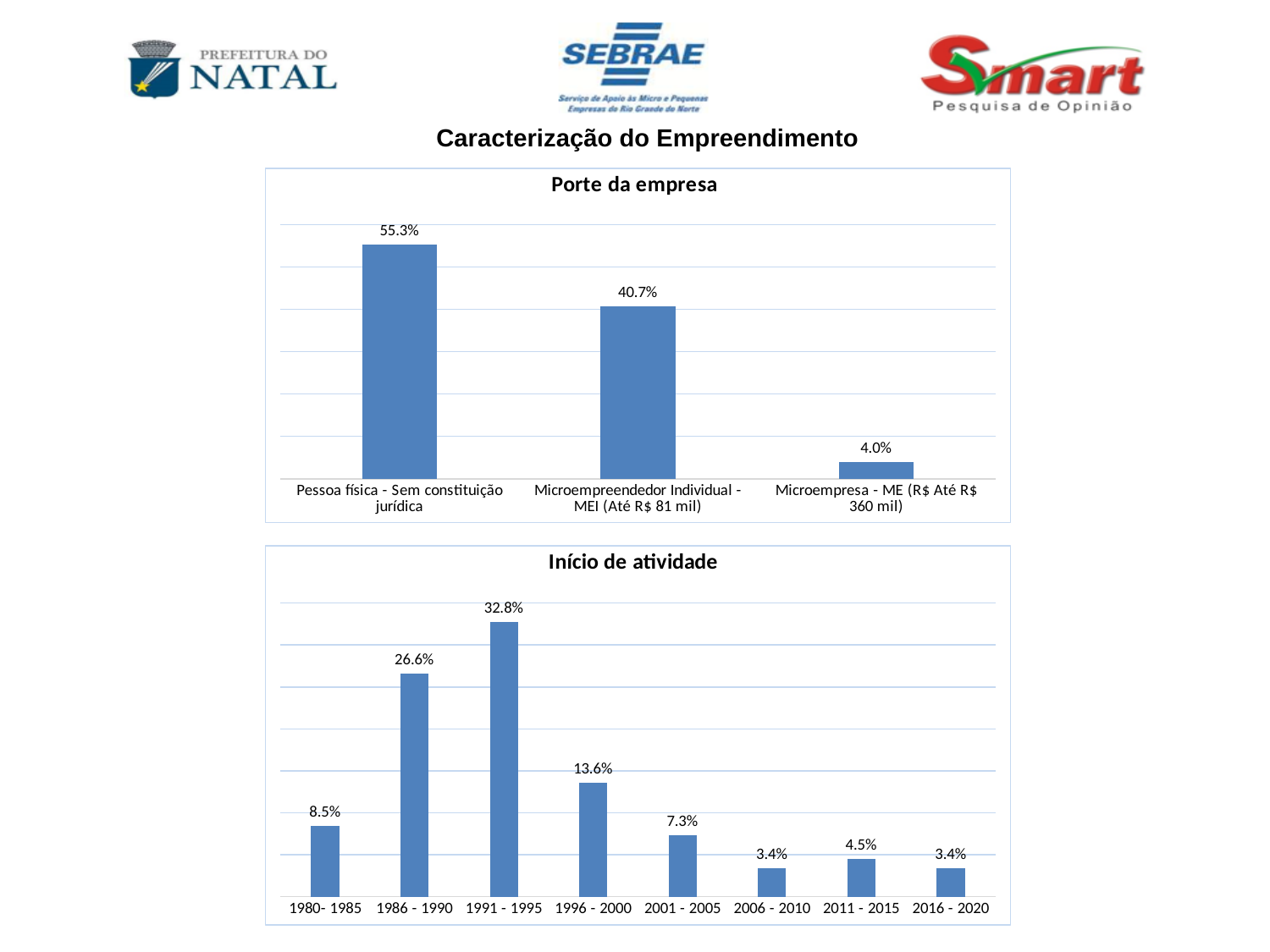
In the 'Porte da empresa' chart, what is the difference between 'Pessoa física - Sem constituição jurídica' and 'Microempreendedor Individual - MEI (Até R$ 81 mil)'? 14.6% In the 'Porte da empresa' chart, which category has the highest value? Pessoa física - Sem constituição jurídica In the 'Início de atividade' chart, what is the value for '1991 - 1995'? 32.8% In the 'Início de atividade' chart, what is the value for '2001 - 2005'? 7.3% In the 'Início de atividade' chart, what is the difference between '1991 - 1995' and '1986 - 1990'? 6.2% In the 'Porte da empresa' chart, what is the value for 'Microempresa - ME (R$ Até R$ 360 mil)'? 4.0% In the 'Início de atividade' chart, how many periods are shown on the x axis? 8 What kind of chart is the 'Início de atividade' chart? Bar chart In the 'Porte da empresa' chart, how many categories are shown? 3 In the 'Início de atividade' chart, which is larger, '1980- 1985' or '2011 - 2015'? 1980- 1985 In the 'Início de atividade' chart, which period has the highest value? 1991 - 1995 In the 'Porte da empresa' chart, what is the value for 'Pessoa física - Sem constituição jurídica'? 55.3%